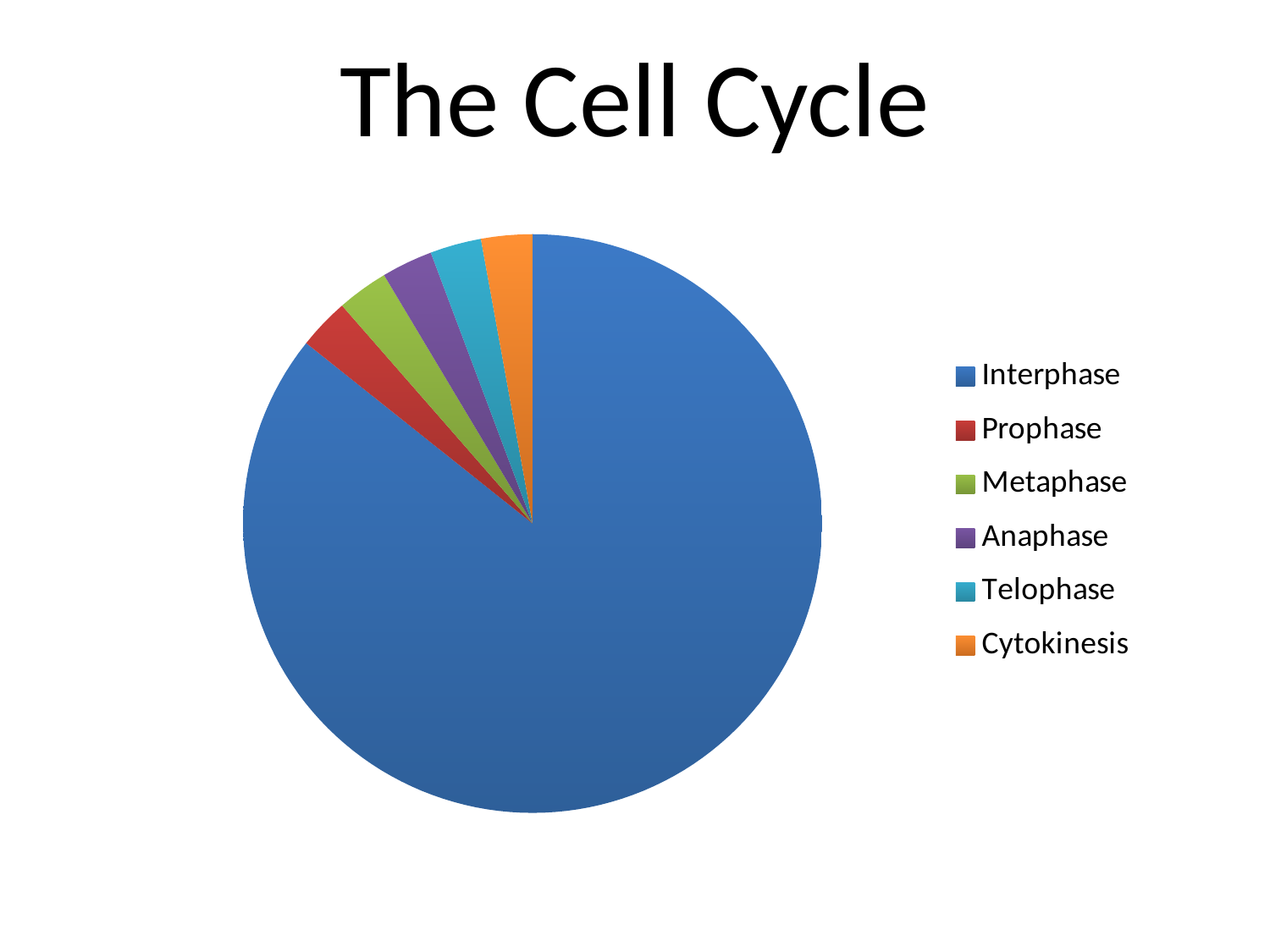
Which is larger in the pie chart, Interphase or Prophase? Interphase What kind of chart is shown on the slide? Pie chart Which category takes up the largest share of the pie chart? Interphase Does Interphase take up more or less than half of the pie chart? More Which is larger in the pie chart, Cytokinesis or Interphase? Interphase Which category is shown in orange in the pie chart? Cytokinesis How many categories (slices) does the pie chart have? 6 What is the title of the chart on the slide? The Cell Cycle